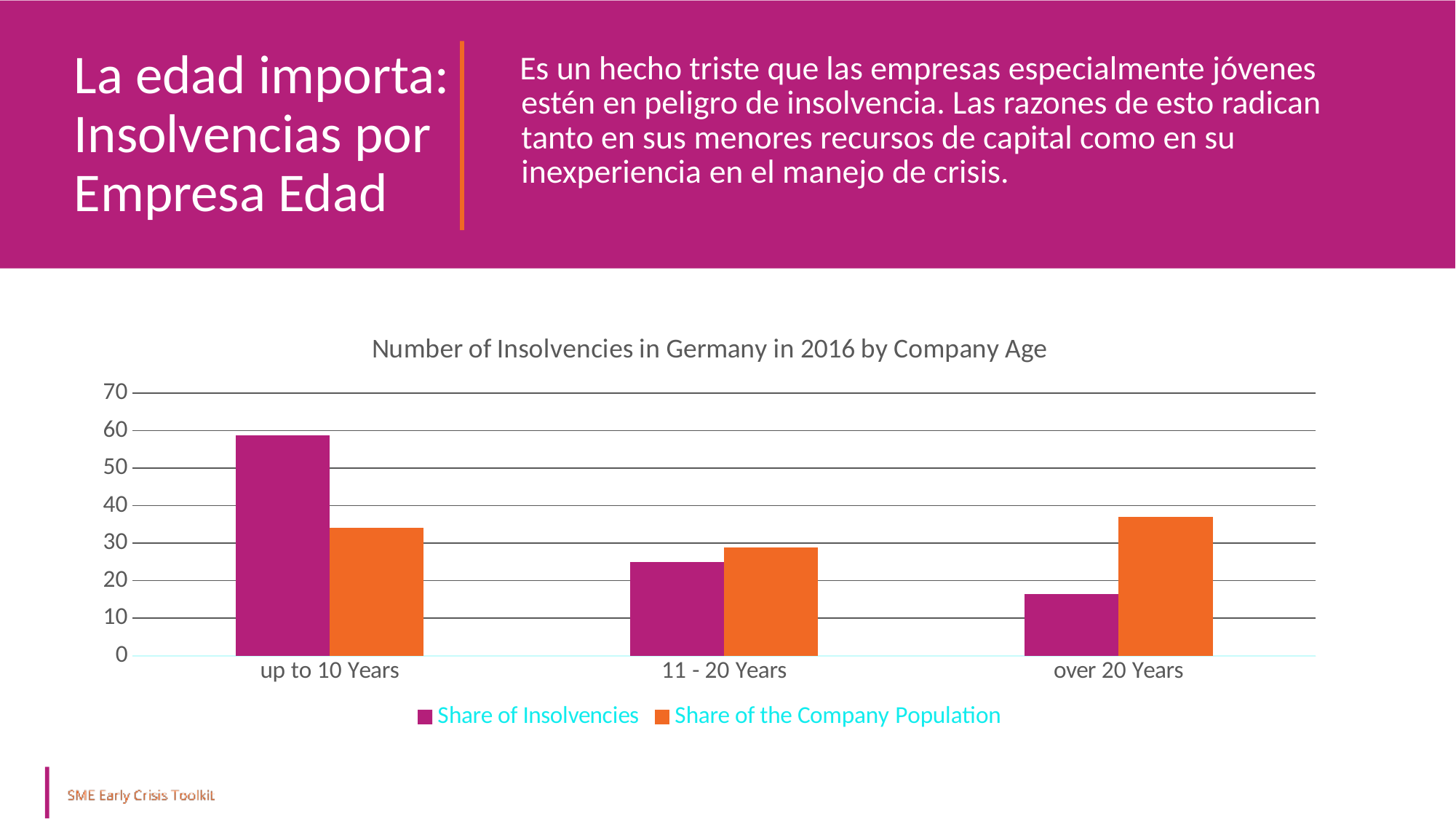
Is the Share of Insolvencies for over 20 Years greater or less than 20? less What type of chart is shown on the slide? bar chart What is the title of the chart? Number of Insolvencies in Germany in 2016 by Company Age Which company age category has the highest Share of Insolvencies? up to 10 Years How many company age categories are shown on the x axis? 3 Which company age category has the lowest Share of Insolvencies? over 20 Years For over 20 Years, which is larger: Share of Insolvencies or Share of the Company Population? Share of the Company Population Is the Share of the Company Population for over 20 Years greater or less than 30? greater Is the Share of Insolvencies for up to 10 Years greater or less than 50? greater Which company age category has the lowest Share of the Company Population? 11 - 20 Years How many series does the legend list? 2 Does the Share of Insolvencies rise or fall as company age increases along the x axis? fall